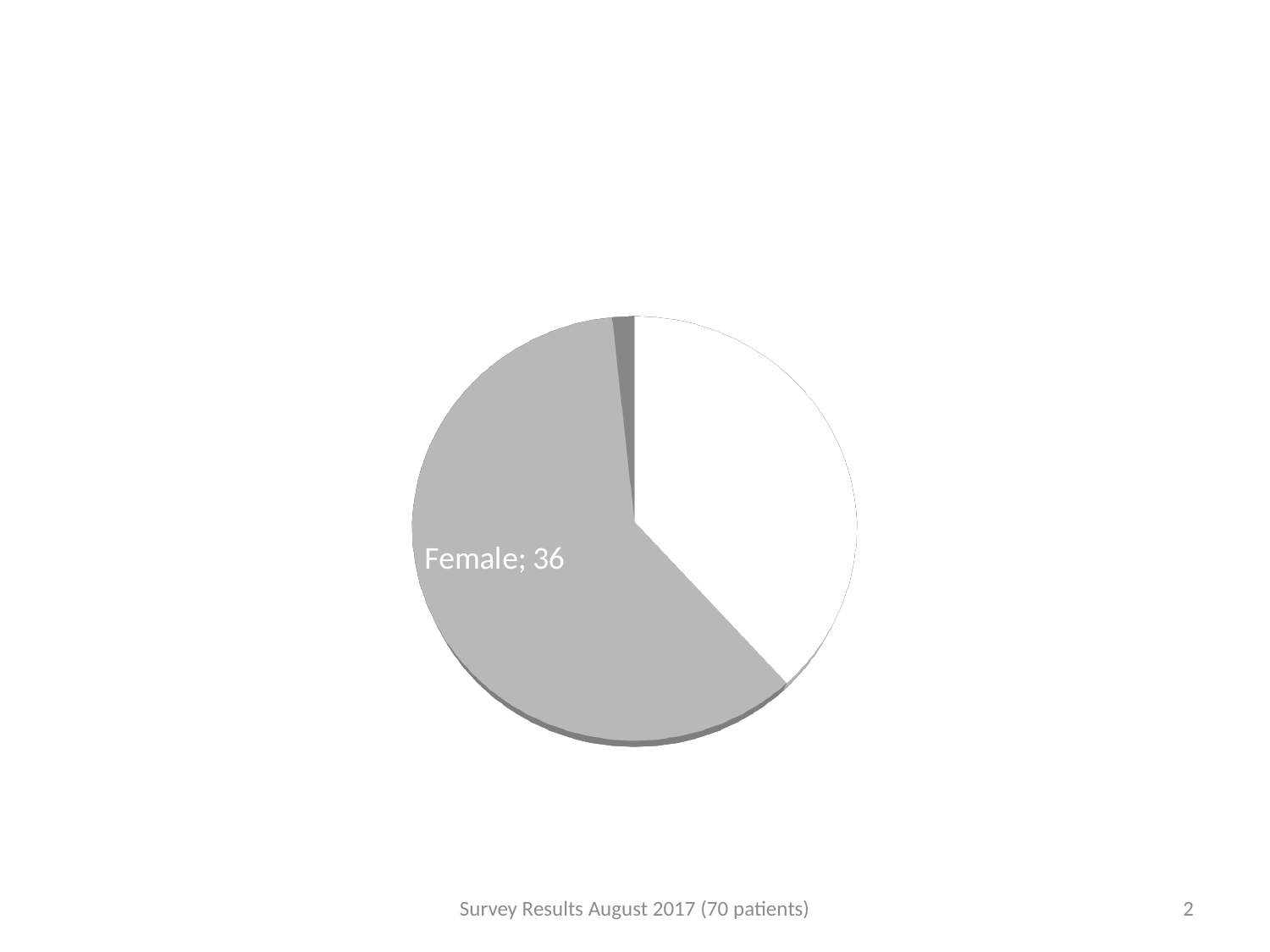
Which slice of the pie chart has a data label? Female What kind of chart is shown on the slide? pie chart Is the Female slice larger or smaller than the small dark grey slice at the top of the pie? larger How many slices does the pie chart have? 3 What is the full text of the data label shown on the pie chart? Female; 36 What is the value shown for Female in the pie chart? 36